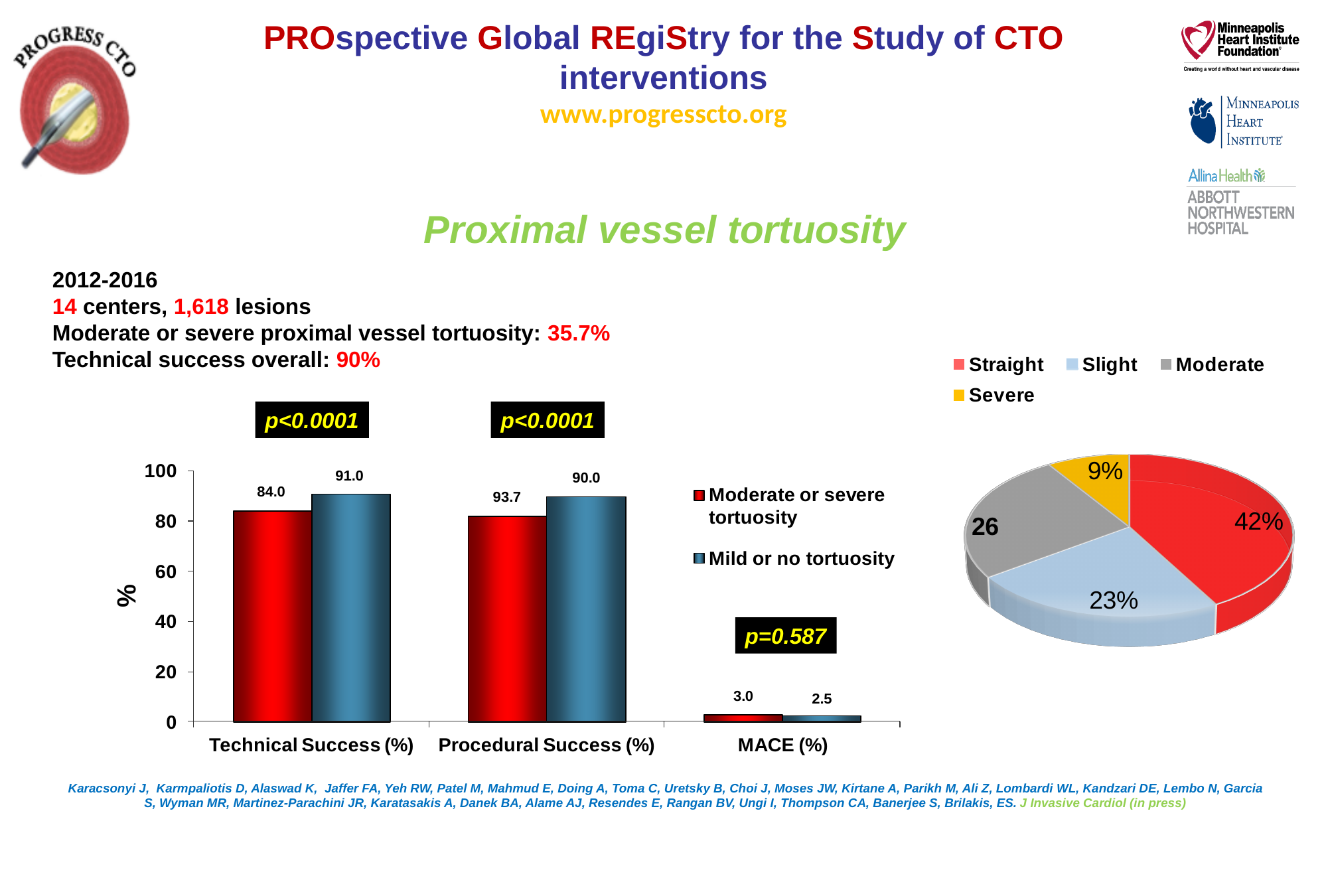
In the bar chart on the left, what is the Procedural Success (%) data label for Moderate or severe tortuosity? 93.7 In the bar chart on the left, how many categories are shown on the x axis? 3 What kind of chart is the chart on the left of the slide? Bar chart In the pie chart on the right, which category has the largest slice? Straight In the bar chart on the left, what is the difference between the Technical Success (%) values for Mild or no tortuosity and Moderate or severe tortuosity? 7.0 In the bar chart on the left, which series has the higher Technical Success (%) value? Mild or no tortuosity In the bar chart on the left, what is the MACE (%) value for Moderate or severe tortuosity? 3.0 In the bar chart on the left, what is the difference between the MACE (%) values for Moderate or severe tortuosity and Mild or no tortuosity? 0.5 In the pie chart on the right, what share does the Straight slice have? 42% In the bar chart on the left, how many series does the legend list? 2 In the bar chart on the left, what is the Technical Success (%) value for Mild or no tortuosity? 91.0 In the pie chart on the right, which category has the smallest slice? Severe